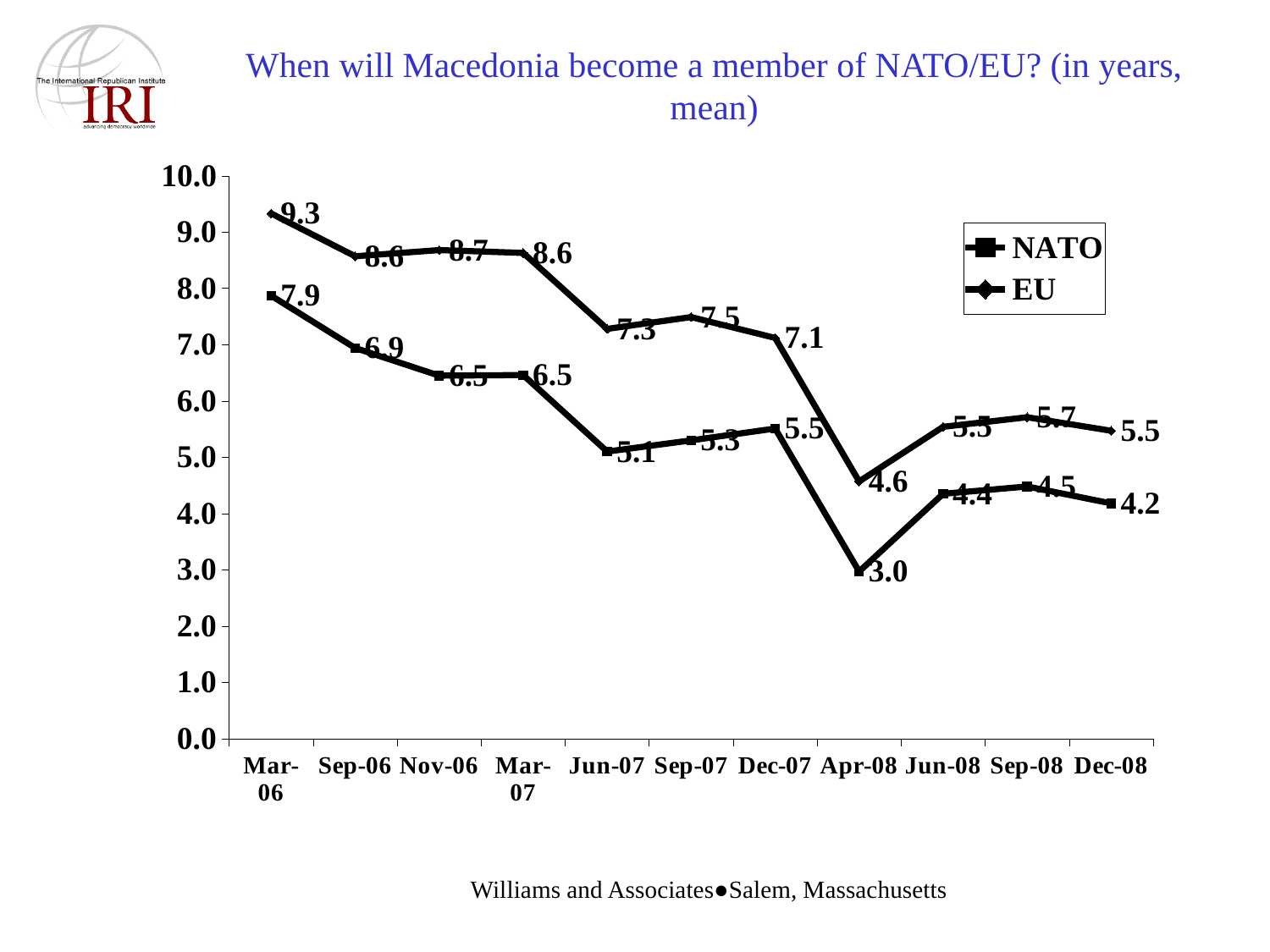
What is the EU value for Mar-06? 9.3 What is the EU value for Dec-08? 5.5 At which date is the EU series highest? Mar-06 What is the difference between the EU and NATO values for Apr-08? 1.6 Which series has the larger value at Jun-07, NATO or EU? EU At which date is the NATO series lowest? Apr-08 How many dates are plotted on the x axis? 11 Do the NATO values generally rise or fall from Mar-06 to Dec-08? fall How many series does the legend list? 2 What is the NATO value for Apr-08? 3.0 What type of chart is shown on the slide? line chart What is the NATO value for Dec-07? 5.5